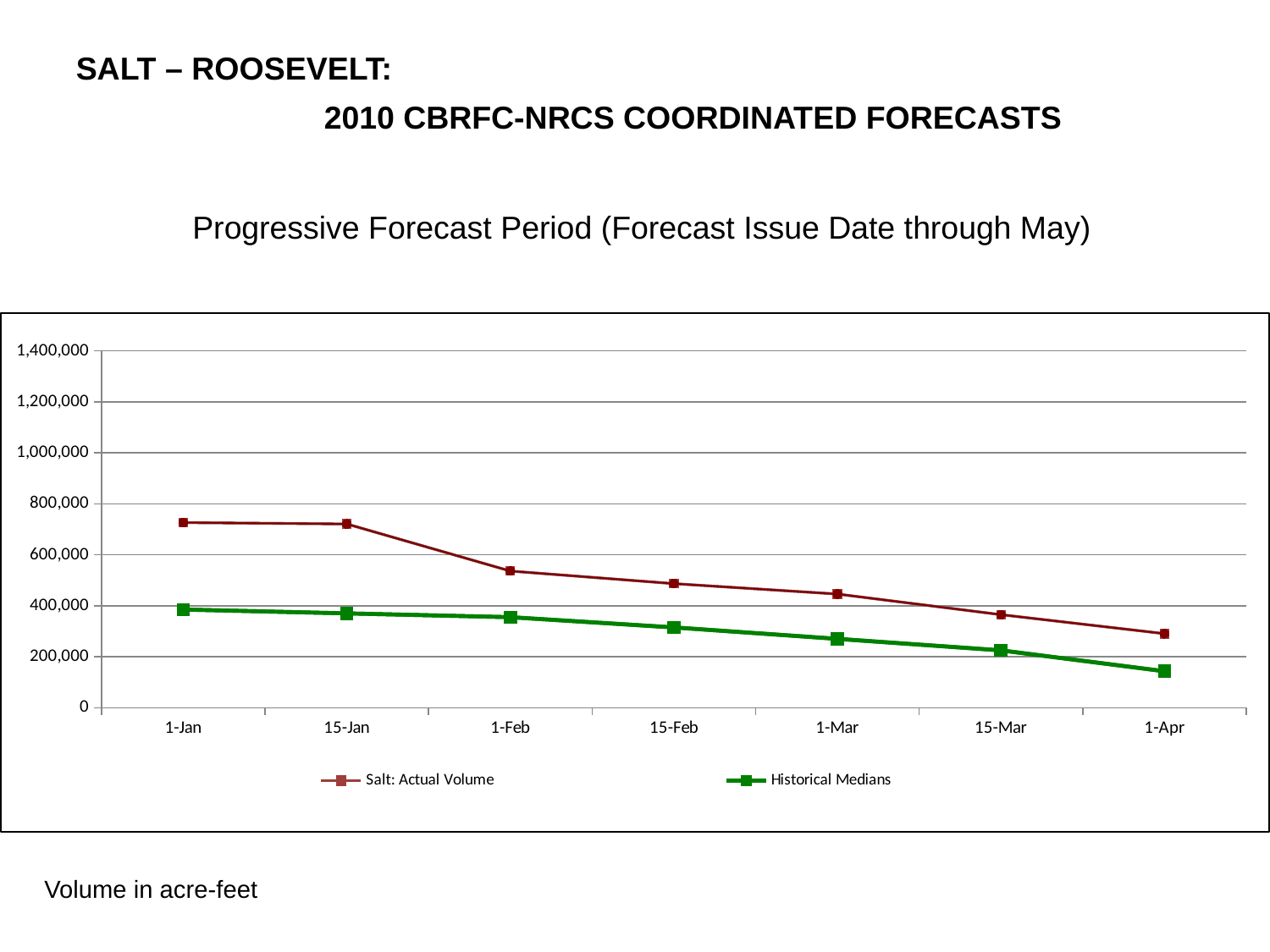
Is the Salt: Actual Volume value at 1-Apr greater or less than 400,000? less What are the two series named in the legend? Salt: Actual Volume and Historical Medians Which series is drawn in green? Historical Medians At which date is the Salt: Actual Volume series at its lowest? 1-Apr Is the Salt: Actual Volume value at 1-Jan greater or less than 600,000? greater How many dates are plotted along the x axis? 7 Do the Salt: Actual Volume values rise or fall from 1-Jan to 1-Apr? fall Is the Historical Medians value at 1-Apr greater or less than 200,000? less At 1-Mar, which series has the higher value, Salt: Actual Volume or Historical Medians? Salt: Actual Volume What kind of chart is shown on the slide? line chart How many series does the chart legend list? 2